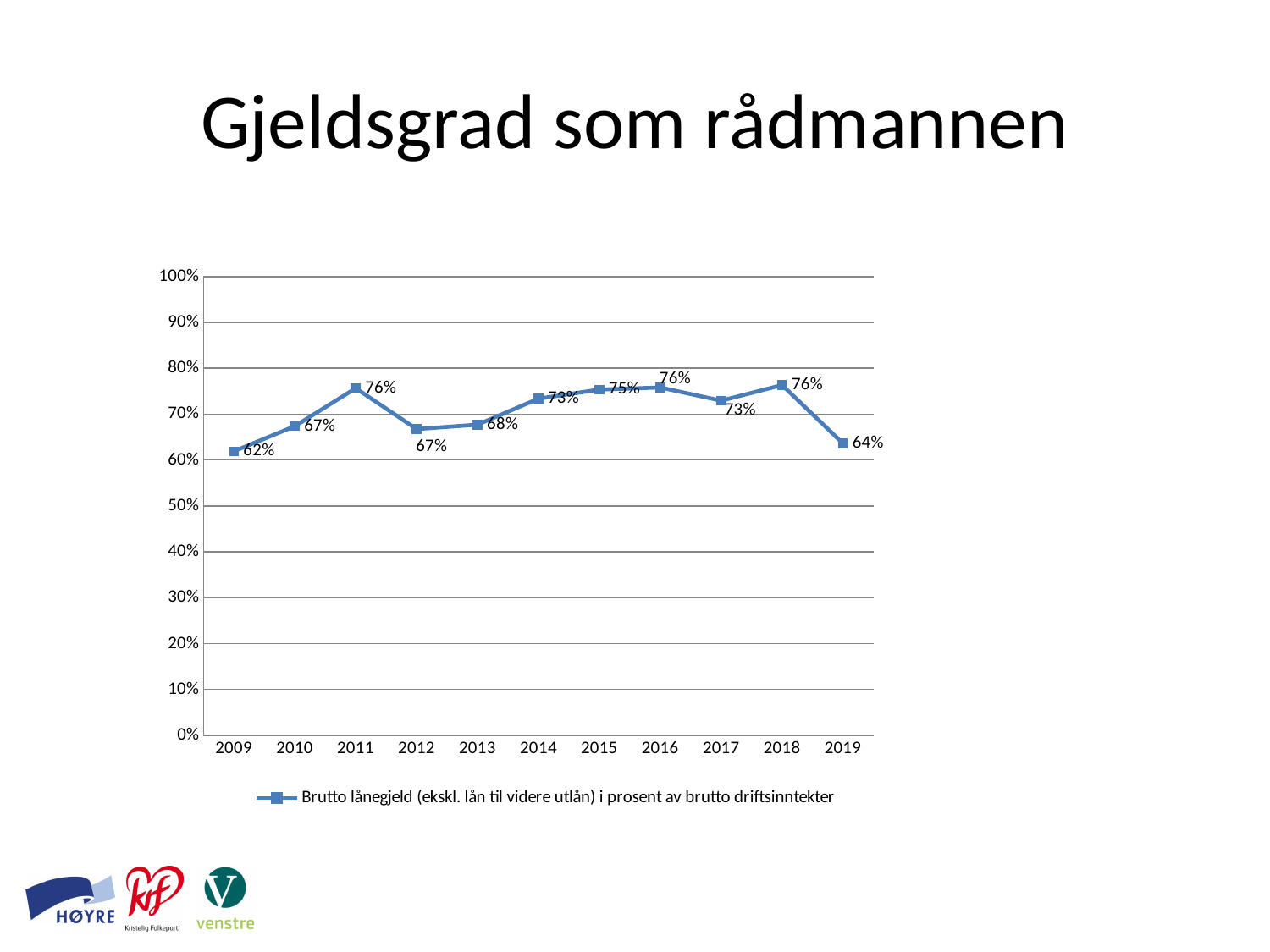
What is the value for 2012? 67% How many series does the legend list? 1 What is the value for 2014? 73% What is the difference between the values for 2009 and 2011? 14% What is the difference between the values for 2018 and 2019? 12% Which is larger, the value for 2015 or the value for 2017? 2015 What type of chart is shown on the slide? line chart What is the title of the slide? Gjeldsgrad som rådmannen What is the value for 2009? 62% How many years are plotted on the x axis? 11 What is the value for 2019? 64% Which year has the lowest value? 2009